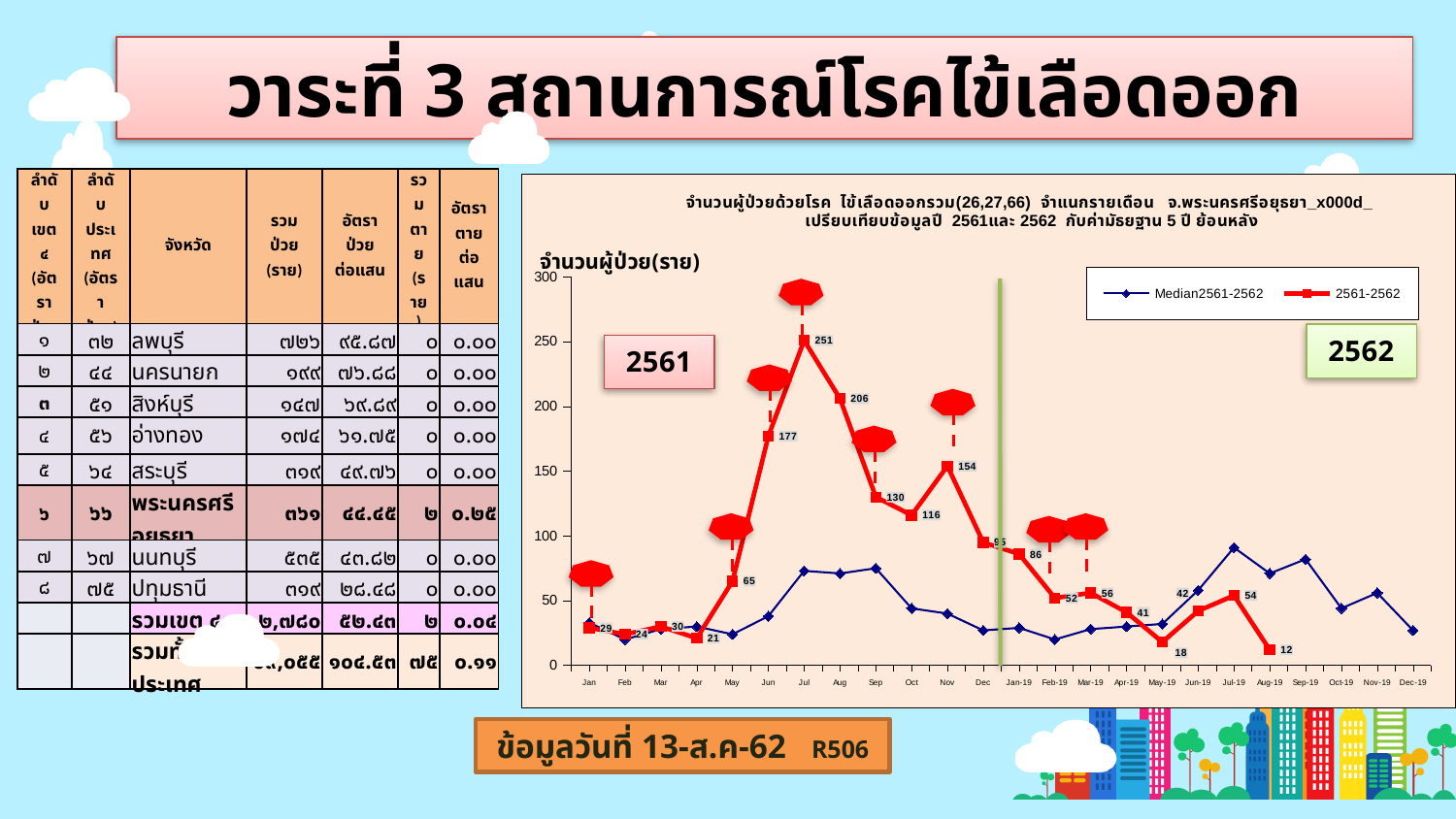
What kind of chart is shown on the slide? line chart Is the value of the Median2561-2562 series in Jul-19 greater or less than 50? greater How many series does the chart legend list? 2 Does the 2561-2562 series rise or fall from Jul to Oct? fall What is the value of the 2561-2562 series in Jul? 251 In which month does the 2561-2562 series reach its highest value? Jul Which is larger for the 2561-2562 series, the value in Aug or the value in Nov? Aug What is the difference between the 2561-2562 values in Jul and Jun? 74 What is the value of the 2561-2562 series in Jun? 177 What is the value of the 2561-2562 series in Aug-19? 12 How many months are shown on the x axis of the chart? 24 In which month does the 2561-2562 series reach its lowest value? Aug-19